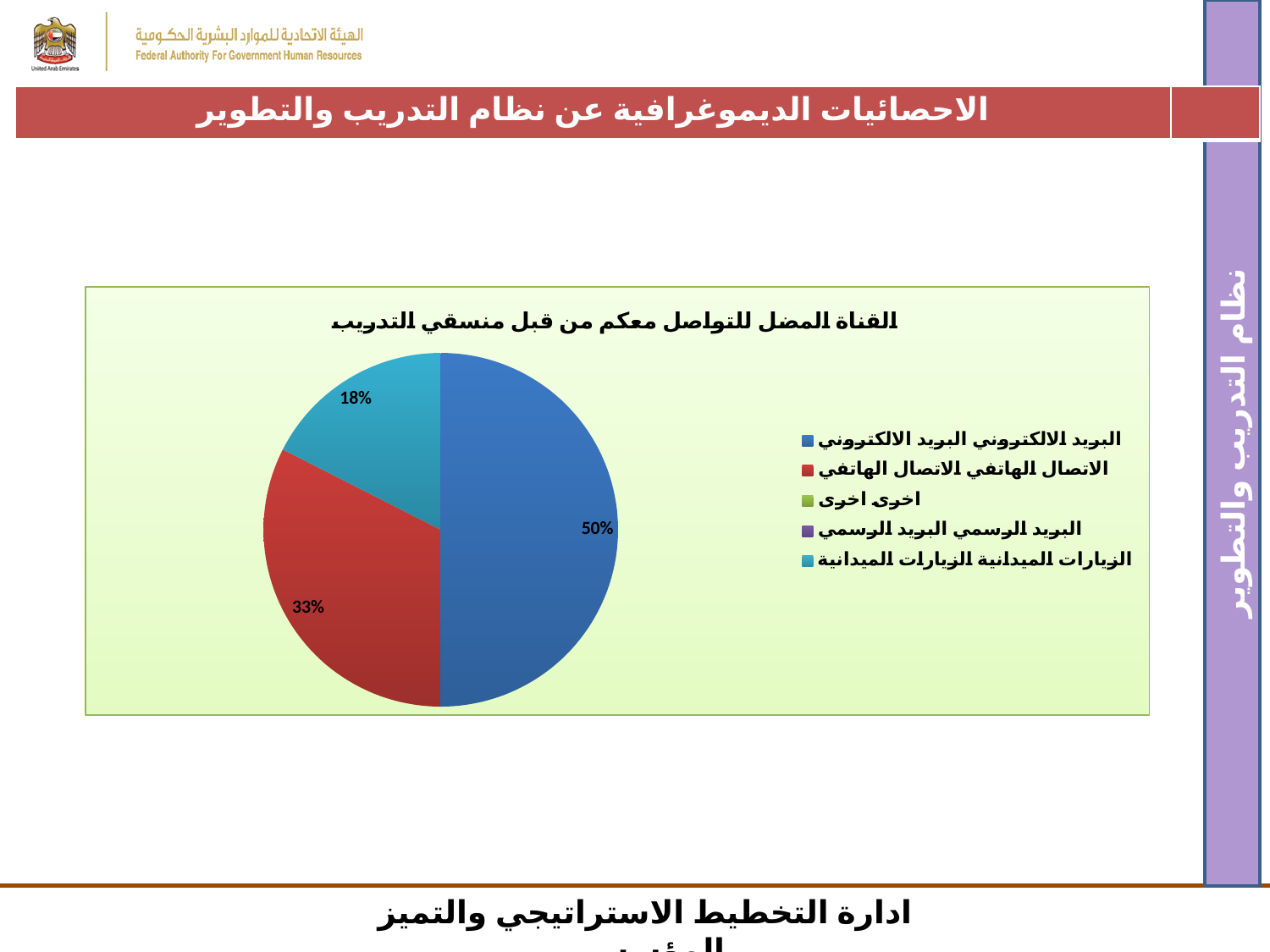
Which is larger, the share for الاتصال الهاتفي or the share for الزيارات الميدانية? الاتصال الهاتفي Among the slices with printed labels, which category has the smallest share? الزيارات الميدانية What is the difference in percentage points between the البريد الالكتروني slice and the الاتصال الهاتفي slice? 17 Which category has the largest slice of the pie? البريد الالكتروني What share of the pie does الاتصال الهاتفي (phone call) have? 33% What share of the pie does الزيارات الميدانية (field visits) have? 18% How many entries does the legend list? 5 What is the difference in percentage points between the الاتصال الهاتفي slice and the الزيارات الميدانية slice? 15 What share of the pie does البريد الالكتروني (email) have? 50% What colour is the slice labelled 50%? blue What kind of chart is shown on the slide? pie chart How many slices with printed percentage labels are visible in the pie? 3